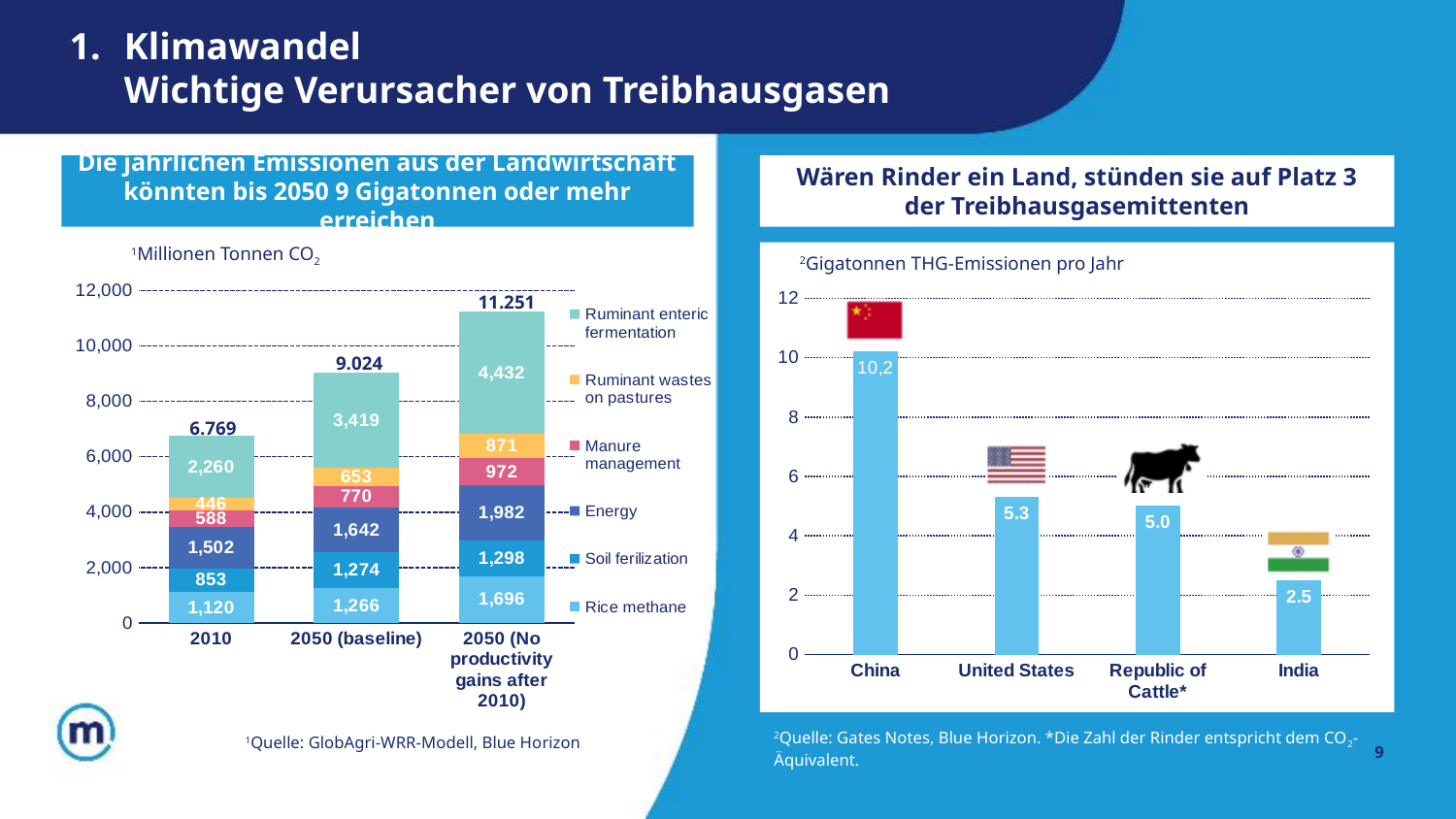
What kind of chart is the right chart? bar chart In the left chart, how many series does the legend list? 6 In the left chart, what is the Rice methane value for 2050 (No productivity gains after 2010)? 1,696 In the left chart, what is the Ruminant enteric fermentation value for 2050 (baseline)? 3,419 In the left chart, which series is shown in the topmost segment of each bar? Ruminant enteric fermentation In the left chart, do the total emissions rise or fall from 2010 to 2050 (No productivity gains after 2010)? rise In the right chart (Gigatonnen THG-Emissionen pro Jahr), what is the value for China? 10,2 In the right chart, what is the difference between the United States and India values? 2.8 In the left chart, what is the difference between the Energy values for 2050 (No productivity gains after 2010) and 2010? 480 In the left chart (annual agricultural emissions), what is the total for the 2010 bar? 6.769 In the right chart, which category has the lowest value? India In the right chart, how many categories are shown? 4